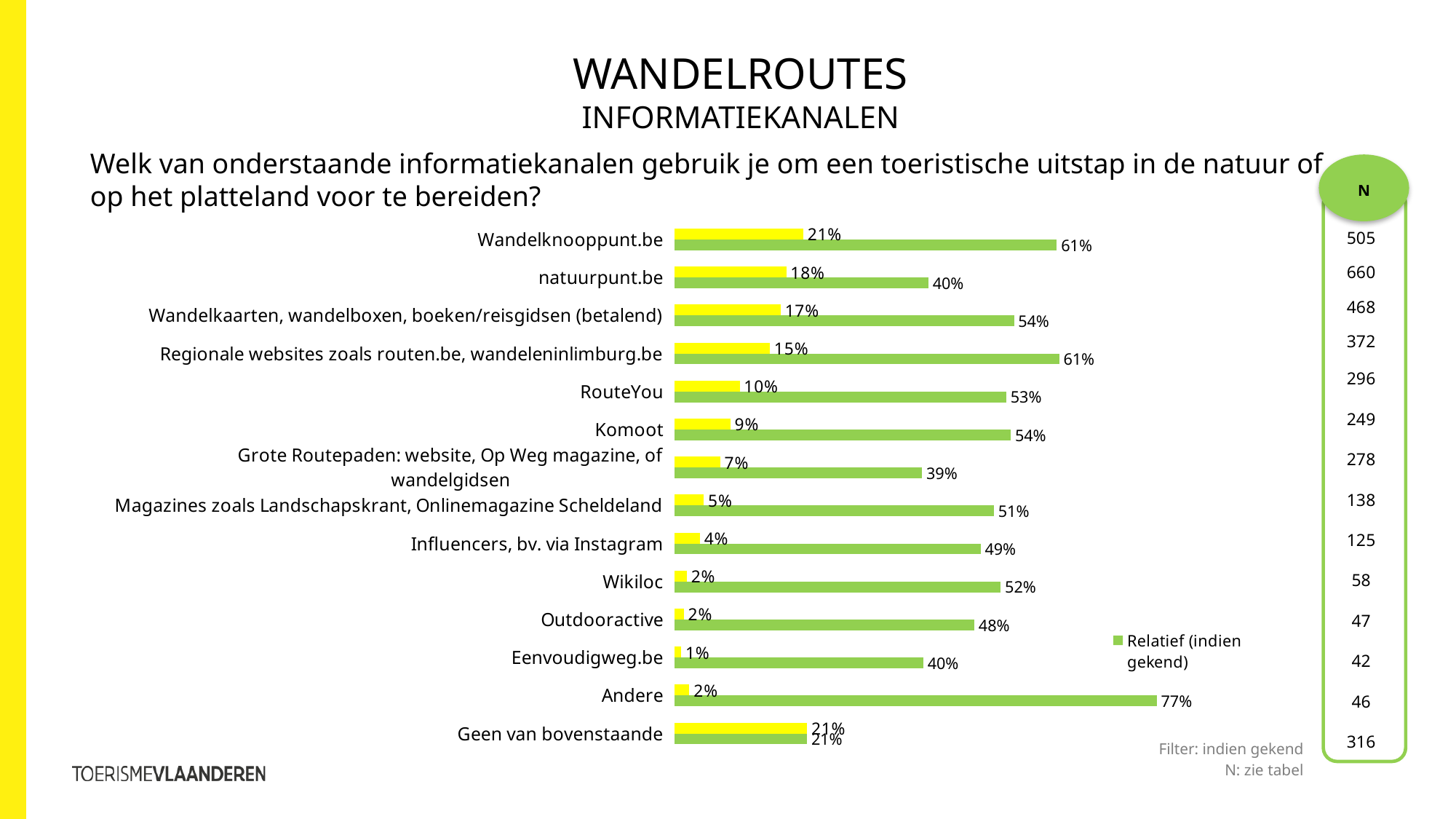
Which has a larger 'Relatief (indien gekend)' value, RouteYou or Grote Routepaden: website, Op Weg magazine, of wandelgidsen? RouteYou Which category has the highest 'Relatief (indien gekend)' value? Andere What is the value of the yellow bar for Eenvoudigweg.be? 1% What type of chart is shown on the slide? bar chart How many categories are shown in the chart? 14 What is the N value shown for Wikiloc in the table on the right? 58 What is the difference between the 'Relatief (indien gekend)' values for Wandelknooppunt.be and natuurpunt.be? 21% Which category has the lowest 'Relatief (indien gekend)' value? Geen van bovenstaande Which category has the lowest value in the yellow series? Eenvoudigweg.be What is the value of the yellow bar for natuurpunt.be? 18% What is the 'Relatief (indien gekend)' value for Wandelknooppunt.be? 61% What is the 'Relatief (indien gekend)' value for Komoot? 54%